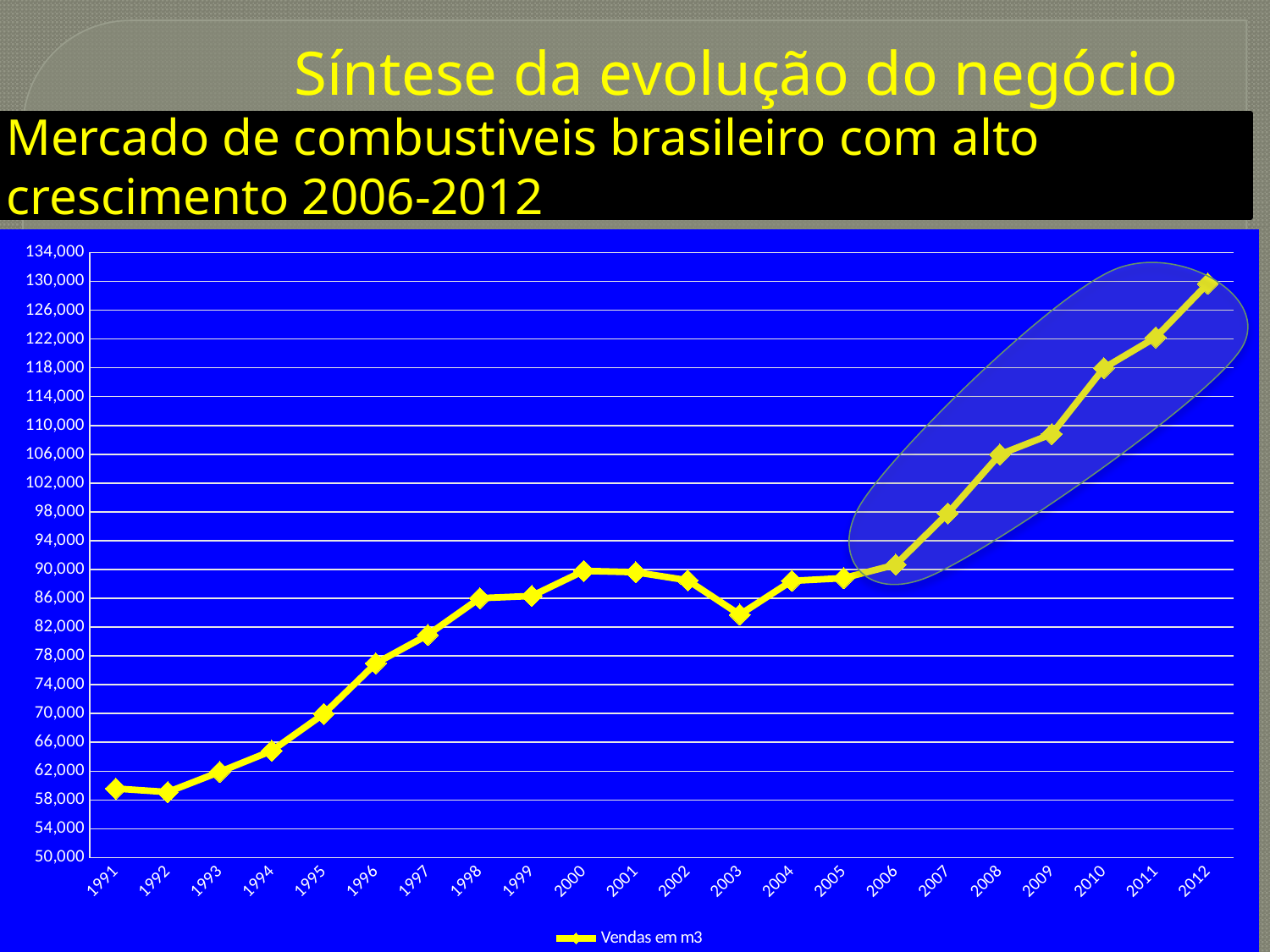
Is the value for 2012 greater or less than 126,000? greater Do the values rise or fall from 2006 to 2012? rise Is the value for 1995 greater or less than 74,000? less Which year has the highest value in the chart? 2012 How many years are plotted along the x axis of the chart? 22 What kind of chart is shown on the slide? line chart What is the name of the series shown in the chart's legend? Vendas em m3 Which year has the larger value, 2001 or 2003? 2001 Is the value for 2008 greater or less than 102,000? greater How many series does the chart's legend list? 1 Which year has the larger value, 2005 or 2010? 2010